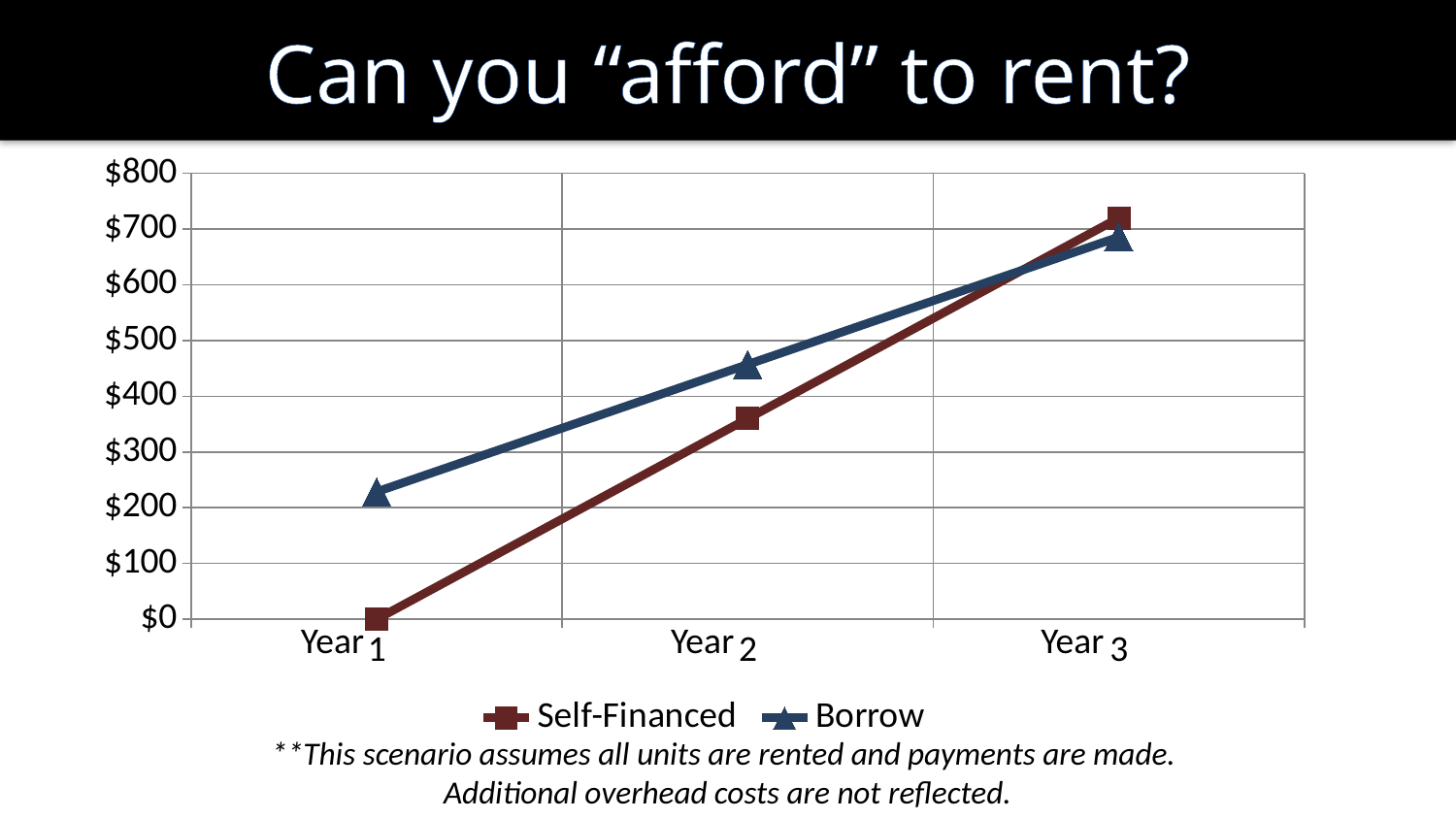
How many years are plotted along the x axis? 3 In Year 2, which series has the larger value, Self-Financed or Borrow? Borrow What kind of chart is shown on the slide? line chart How many series does the legend list? 2 Is the Self-Financed value for Year 3 greater or less than $600? greater Is the Borrow value for Year 2 greater or less than $400? greater Is the Borrow value for Year 1 greater or less than $300? less Do the Self-Financed values rise or fall from Year 1 to Year 3? rise What is the title of the slide? Can you "afford" to rent? In which year is the Self-Financed value lowest? Year 1 What is the Self-Financed value in Year 1? $0